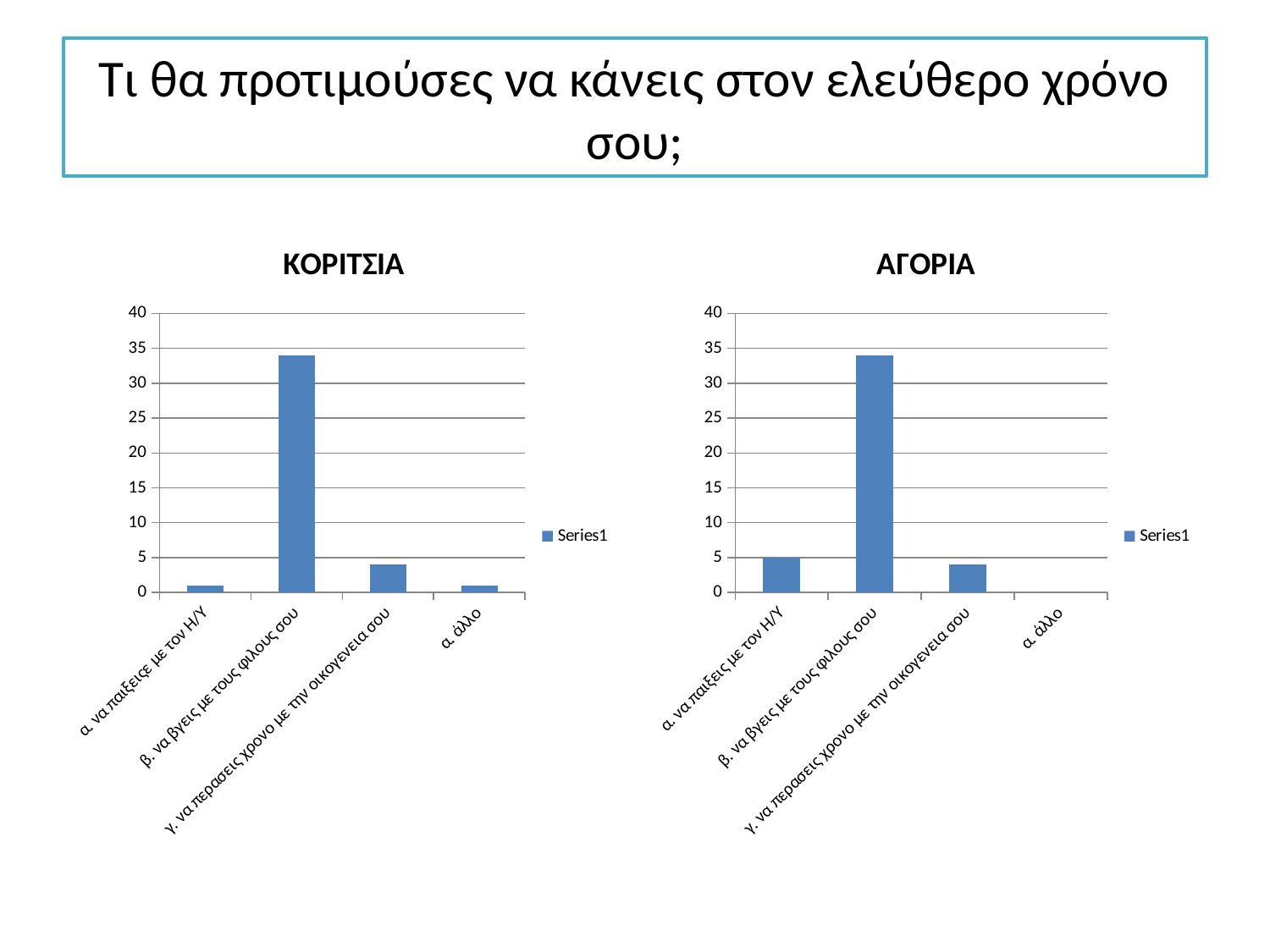
In the ΚΟΡΙΤΣΙΑ chart, is the value for α. να παιξεις με τον Η/Υ greater or less than 5? less What is the title of the chart on the right? ΑΓΟΡΙΑ How many categories are shown on the x axis of the ΑΓΟΡΙΑ chart on the right? 4 In the ΑΓΟΡΙΑ chart, which is larger: the value for α. να παιξεις με τον Η/Υ or the value for α. άλλο? α. να παιξεις με τον Η/Υ How many series does the legend of the ΚΟΡΙΤΣΙΑ chart list? 1 In the ΚΟΡΙΤΣΙΑ chart, is the value for β. να βγεις με τους φιλους σου greater or less than 30? greater What kind of chart is the ΚΟΡΙΤΣΙΑ chart on the left? bar chart In the ΑΓΟΡΙΑ chart, is the value for γ. να περασεις χρονο με την οικογενεια σου greater or less than 10? less In the ΑΓΟΡΙΑ chart, which category has the lowest value? α. άλλο In the ΑΓΟΡΙΑ chart, which category has the highest value? β. να βγεις με τους φιλους σου In the ΚΟΡΙΤΣΙΑ chart, which is larger: the value for γ. να περασεις χρονο με την οικογενεια σου or the value for α. άλλο? γ. να περασεις χρονο με την οικογενεια σου In the ΚΟΡΙΤΣΙΑ chart, which category has the highest value? β. να βγεις με τους φιλους σου